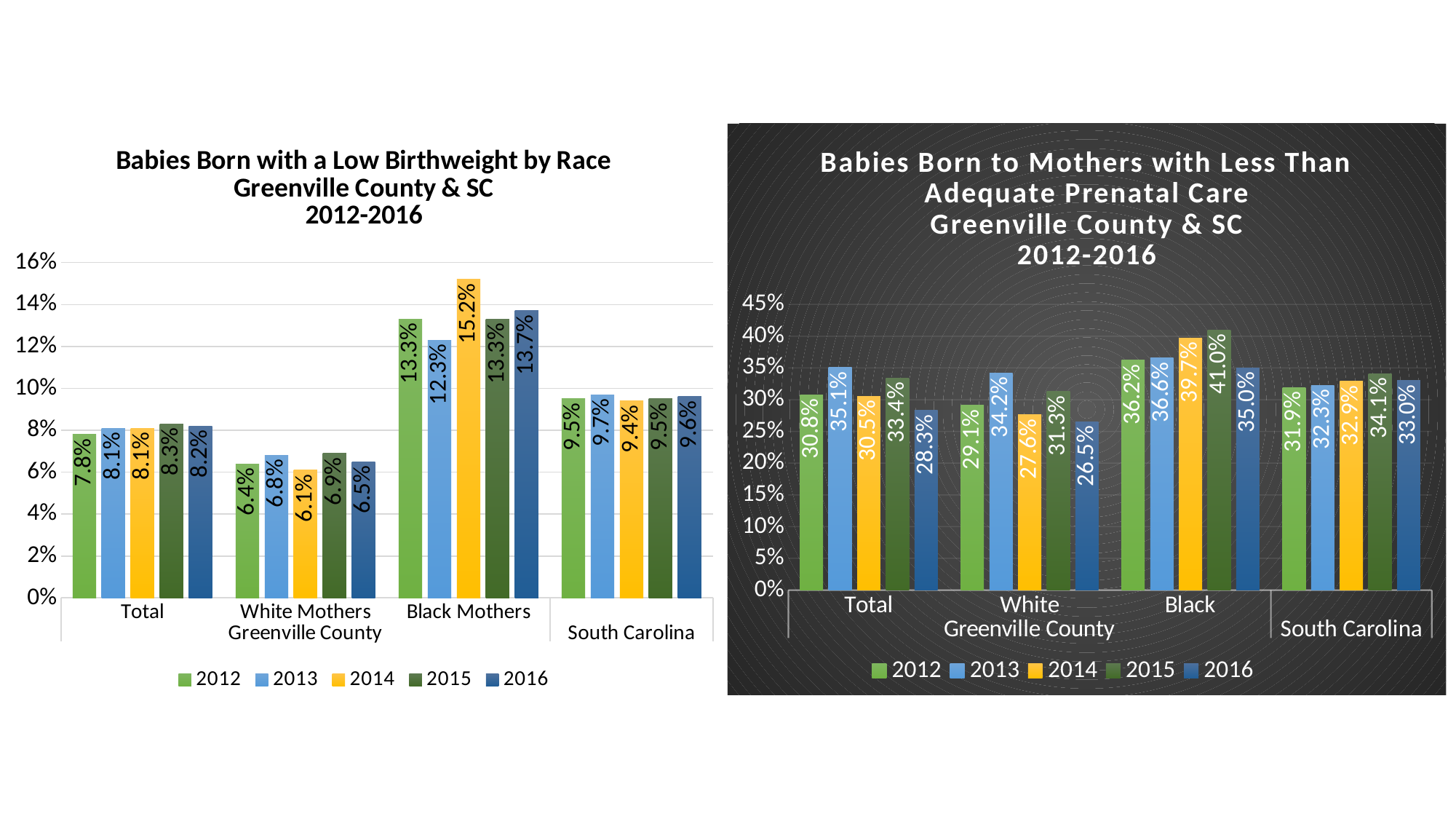
In the 'Babies Born with a Low Birthweight by Race' chart, what is the value for White Mothers in 2016? 6.5% In the 'Babies Born with a Low Birthweight by Race' chart, what is the difference between the 2014 values for Black Mothers and White Mothers? 9.1% In the 'Babies Born to Mothers with Less Than Adequate Prenatal Care' chart, what is the value for South Carolina in 2012? 31.9% What kind of chart is the 'Babies Born to Mothers with Less Than Adequate Prenatal Care' chart? Bar chart In the 'Babies Born with a Low Birthweight by Race' chart, which year has the lowest value for White Mothers? 2014 In the 'Babies Born to Mothers with Less Than Adequate Prenatal Care' chart, which is larger, the 2013 value for Total or the 2013 value for South Carolina? Total In the 'Babies Born to Mothers with Less Than Adequate Prenatal Care' chart, what is the difference between the 2016 values for Black and White? 8.5% In the 'Babies Born with a Low Birthweight by Race' chart, which year has the highest value for Black Mothers? 2014 In the 'Babies Born with a Low Birthweight by Race' chart, how many series does the legend list? 5 In the 'Babies Born to Mothers with Less Than Adequate Prenatal Care' chart, which year has the lowest value for White? 2016 In the 'Babies Born with a Low Birthweight by Race' chart, what is the value for Black Mothers in 2014? 15.2% In the 'Babies Born to Mothers with Less Than Adequate Prenatal Care' chart, what is the value for Black in 2015? 41.0%